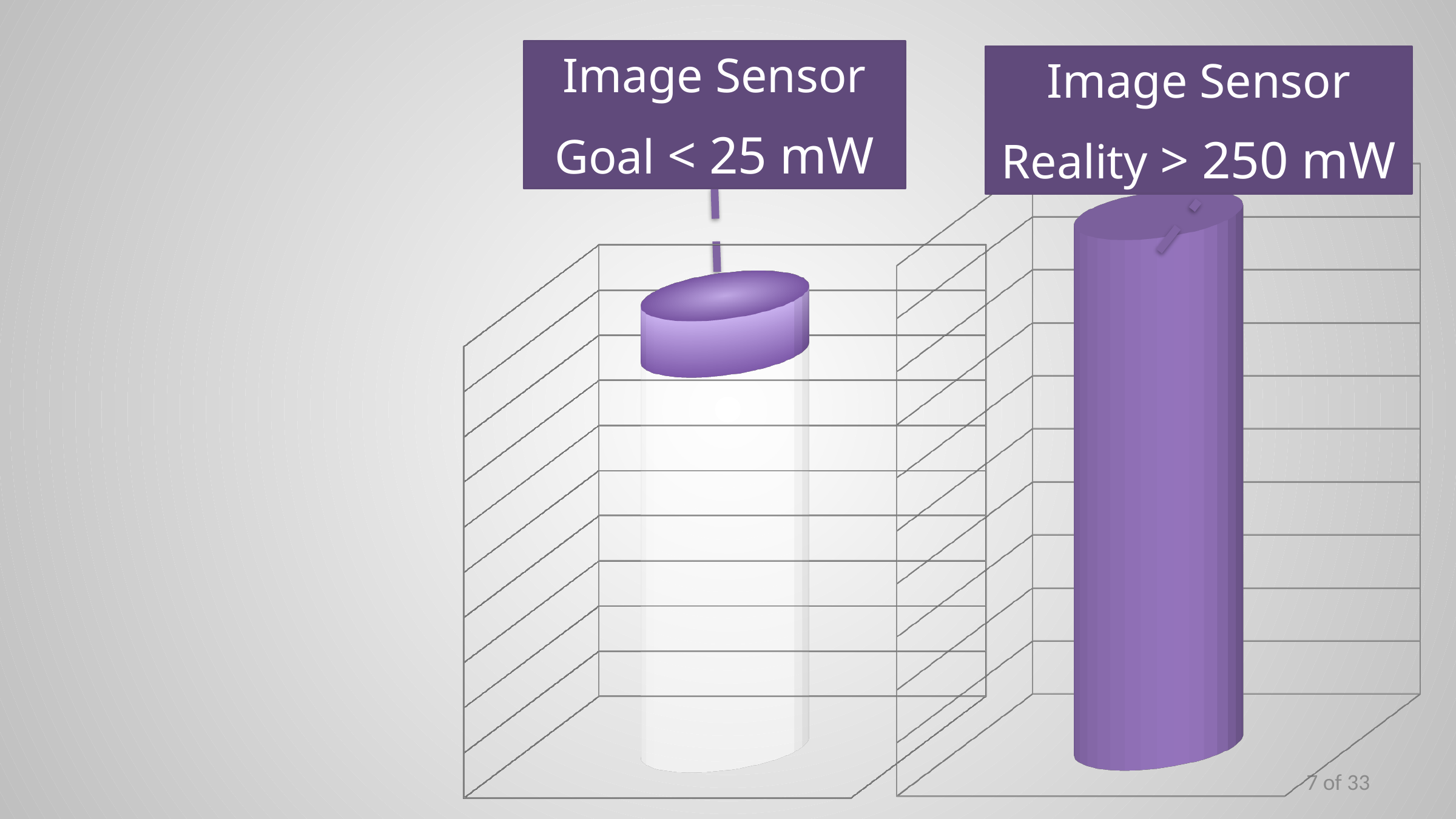
What kind of chart is used on this slide? bar chart Which bar is taller, the Image Sensor Goal bar on the left or the Image Sensor Reality bar on the right? Image Sensor Reality What power level does the callout above the left chart state as the Image Sensor goal? < 25 mW How many charts are shown on the slide? 2 Which of the two charts shows the lower bar? Image Sensor Goal What power level does the callout above the right chart state as the Image Sensor reality? > 250 mW How many bars does the right chart (Image Sensor Reality) contain? 1